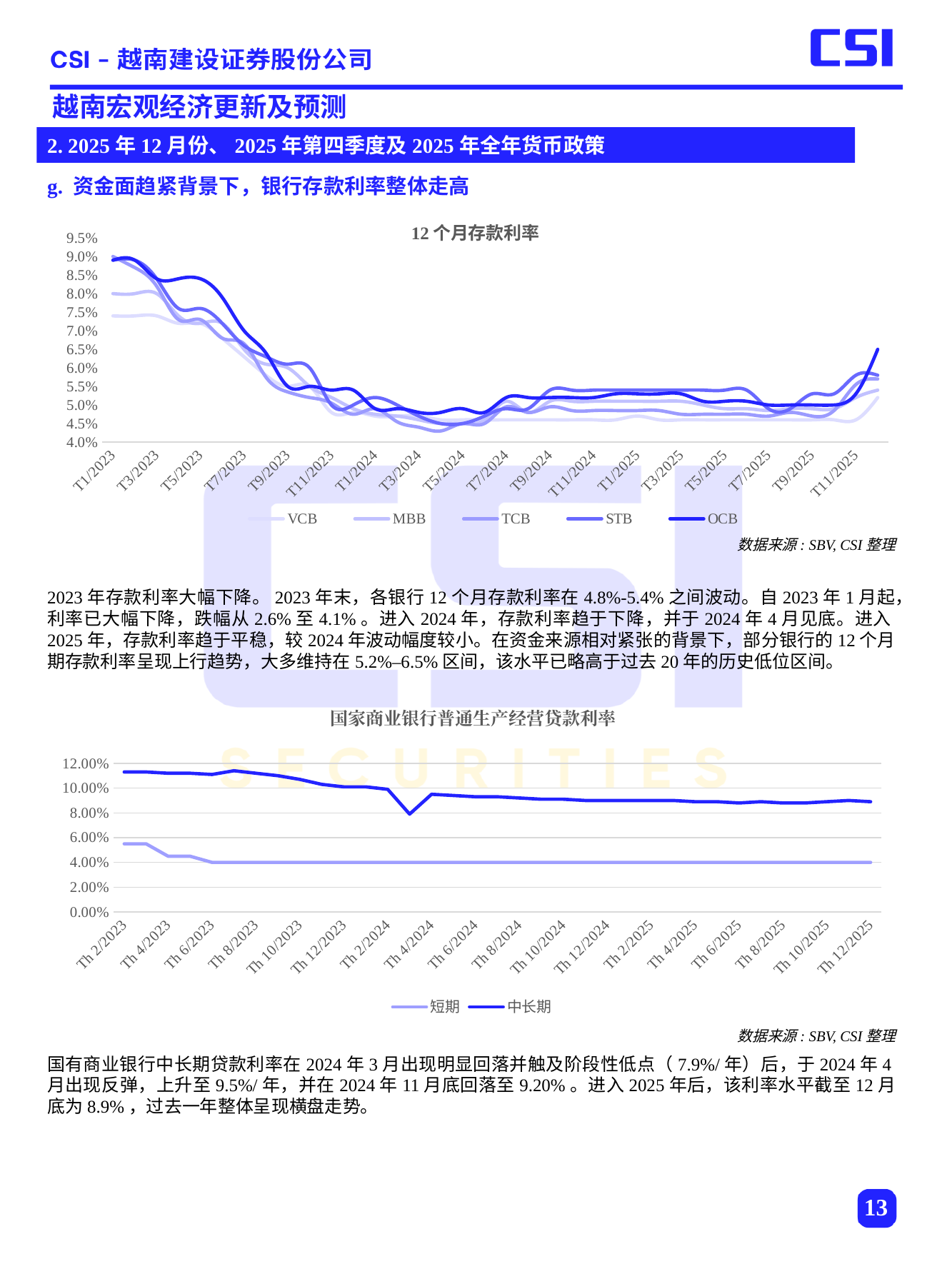
In the bottom chart (国家商业银行普通生产经营贷款利率), is the value for 短期 at Th 12/2025 greater or less than 6.00%? less In the top chart (12个月存款利率), is the value for OCB at T11/2025 greater or less than 6.0%? less What is the title of the bottom chart on the slide? 国家商业银行普通生产经营贷款利率 How many series does the legend of the bottom chart (国家商业银行普通生产经营贷款利率) list? 2 In the bottom chart (国家商业银行普通生产经营贷款利率), does the 中长期 line rise or fall from Th 2/2023 to Th 12/2025? fall How many series does the legend of the top chart (12个月存款利率) list? 5 In the bottom chart (国家商业银行普通生产经营贷款利率), is the value for 中长期 at Th 2/2023 greater or less than 10.00%? greater What kind of chart is the top chart titled 12个月存款利率? line chart In the bottom chart (国家商业银行普通生产经营贷款利率), which series is higher at Th 12/2025, 短期 or 中长期? 中长期 In the top chart (12个月存款利率), do the deposit rates generally rise or fall from T1/2023 to T5/2024? fall In the top chart (12个月存款利率), which bank is listed last in the legend? OCB What kind of chart is the bottom chart titled 国家商业银行普通生产经营贷款利率? line chart